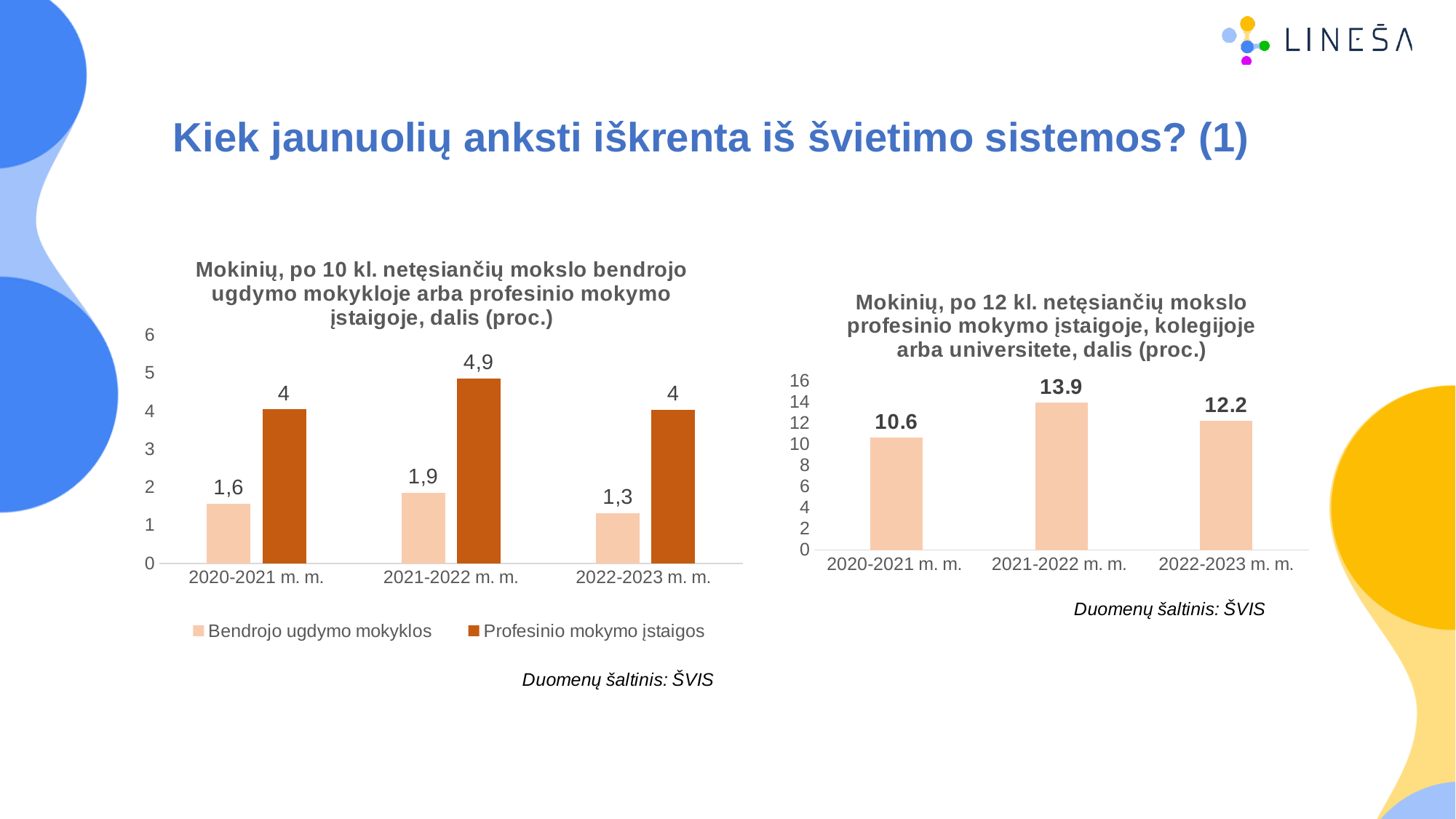
In the right chart (Mokinių, po 12 kl. netęsiančių mokslo...), is the value for 2020-2021 m. m. greater or less than 12? less In the left chart (Mokinių, po 10 kl. netęsiančių mokslo...), how many series does the legend list? 2 In the right chart (Mokinių, po 12 kl. netęsiančių mokslo...), how many school years are shown on the x axis? 3 In the right chart (Mokinių, po 12 kl. netęsiančių mokslo...), which school year has the highest value? 2021-2022 m. m. In the left chart (Mokinių, po 10 kl. netęsiančių mokslo...), what is the value for Bendrojo ugdymo mokyklos in 2021-2022 m. m.? 1,9 What kind of chart is the right chart (Mokinių, po 12 kl. netęsiančių mokslo...)? bar chart In the left chart (Mokinių, po 10 kl. netęsiančių mokslo...), what is the difference between Profesinio mokymo įstaigos and Bendrojo ugdymo mokyklos in 2020-2021 m. m.? 2,4 In the left chart (Mokinių, po 10 kl. netęsiančių mokslo...), what is the value for Profesinio mokymo įstaigos in 2021-2022 m. m.? 4,9 In the right chart (Mokinių, po 12 kl. netęsiančių mokslo...), what is the value for 2020-2021 m. m.? 10.6 In the left chart (Mokinių, po 10 kl. netęsiančių mokslo...), which series is shown in dark orange? Profesinio mokymo įstaigos In the right chart (Mokinių, po 12 kl. netęsiančių mokslo...), what is the difference between 2021-2022 m. m. and 2022-2023 m. m.? 1.7 In the left chart (Mokinių, po 10 kl. netęsiančių mokslo...), which school year has the lowest value for Bendrojo ugdymo mokyklos? 2022-2023 m. m.